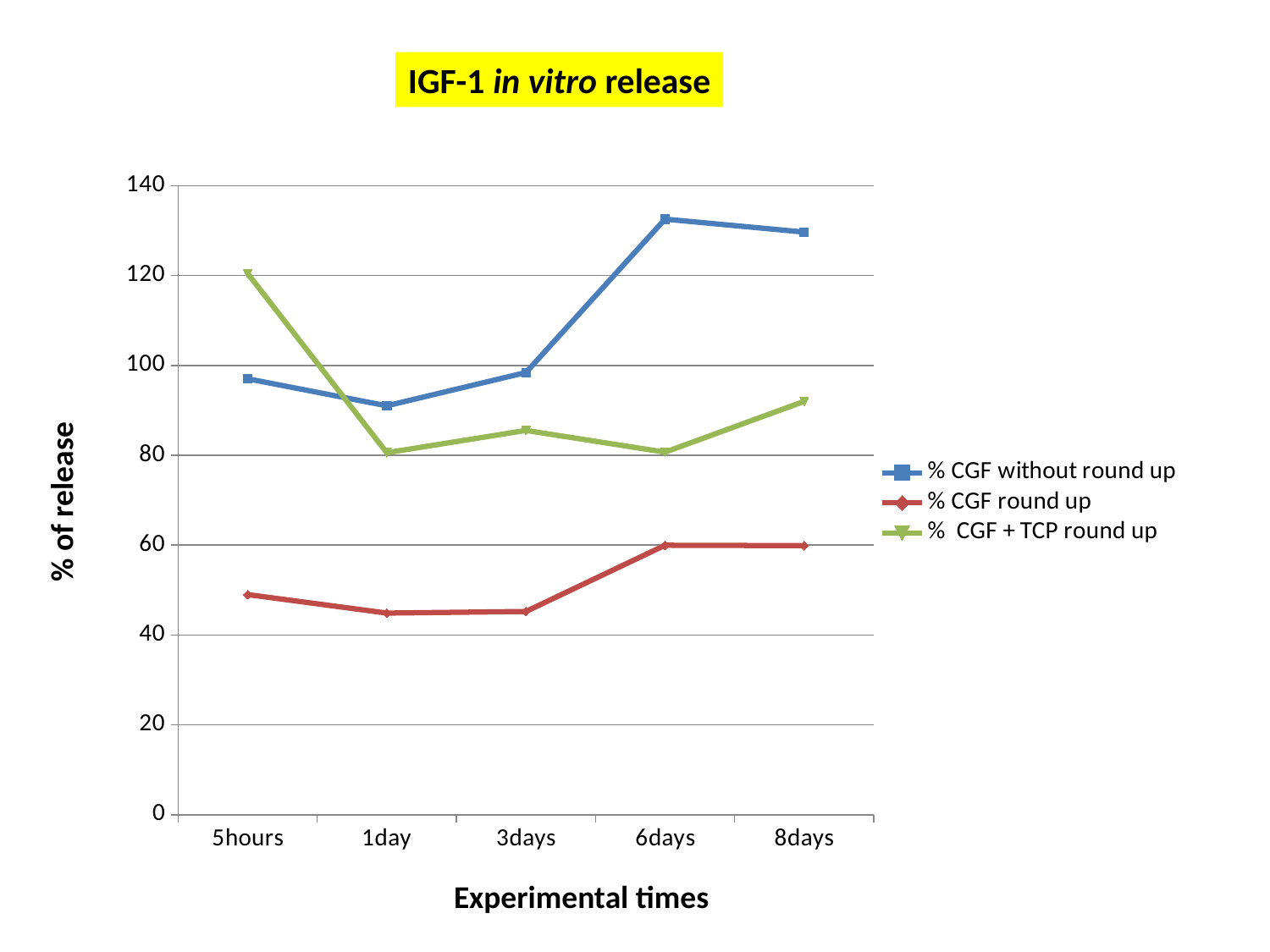
How many experimental time points are shown on the x axis? 5 How many series does the legend list? 3 Is the value for % CGF round up at 1day greater or less than 60? less Does the % CGF without round up series rise or fall between 3days and 6days? rise At which experimental time is the % CGF + TCP round up series highest? 5hours What kind of chart is shown on the slide? line chart Is the value for % CGF without round up at 6days greater or less than 120? greater At 5hours, which series has the higher value: % CGF without round up or % CGF + TCP round up? % CGF + TCP round up Is the value for % CGF + TCP round up at 5hours greater or less than 100? greater What is the title of the y axis? % of release At which experimental time is the % CGF without round up series lowest? 1day